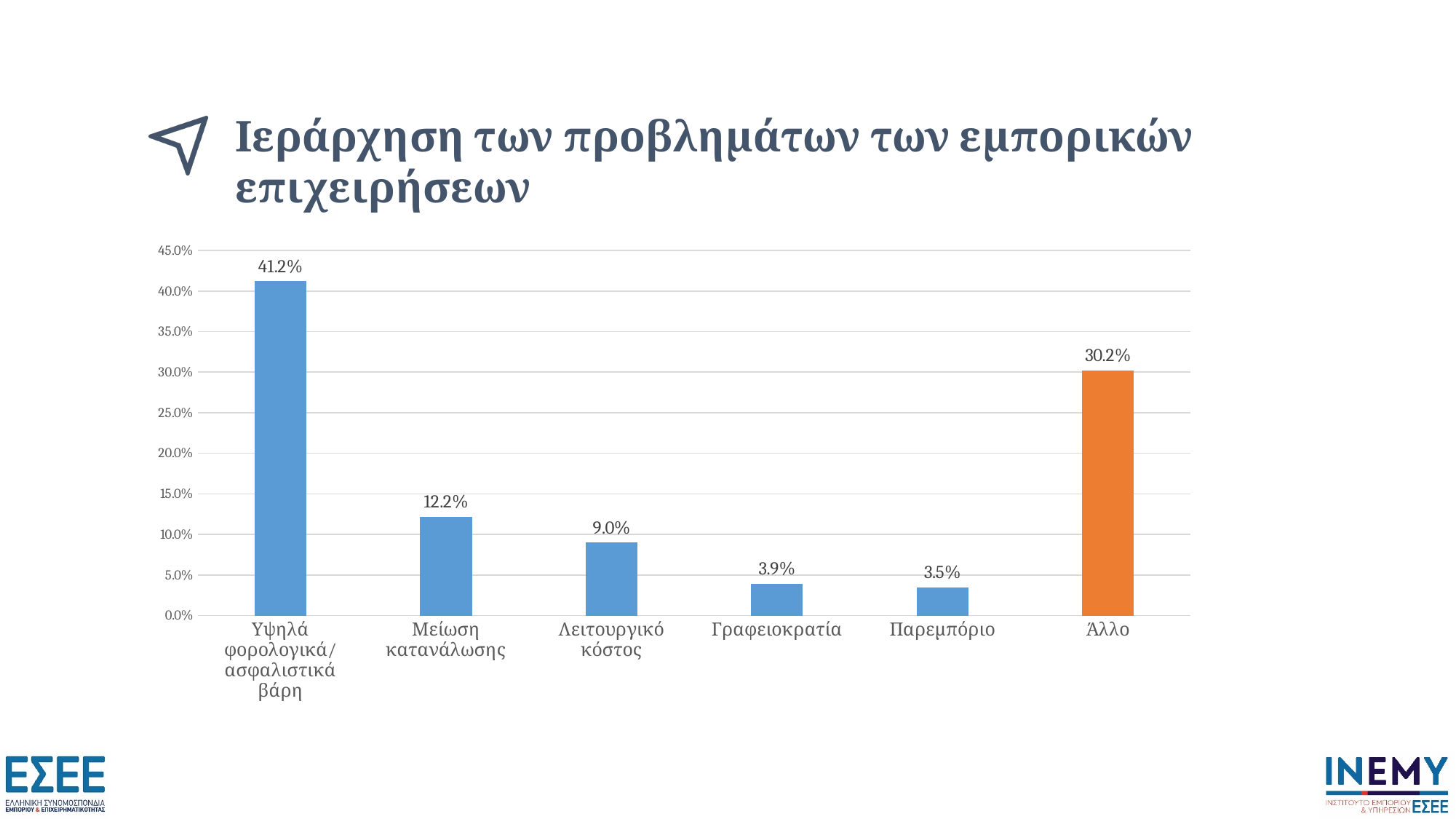
Which bar is coloured orange rather than blue? Άλλο Which is larger, Άλλο or Μείωση κατανάλωσης? Άλλο How many categories are shown on the x axis? 6 What kind of chart is shown on the slide? bar chart Which category has the highest value? Υψηλά φορολογικά/ασφαλιστικά βάρη Is the value for Λειτουργικό κόστος greater or less than 10.0%? less Which category has the lowest value? Παρεμπόριο What is the value for Υψηλά φορολογικά/ασφαλιστικά βάρη? 41.2% What is the difference between Υψηλά φορολογικά/ασφαλιστικά βάρη and Άλλο? 11.0% What is the value for Γραφειοκρατία? 3.9% What is the value for Άλλο? 30.2% What is the difference between Μείωση κατανάλωσης and Λειτουργικό κόστος? 3.2%